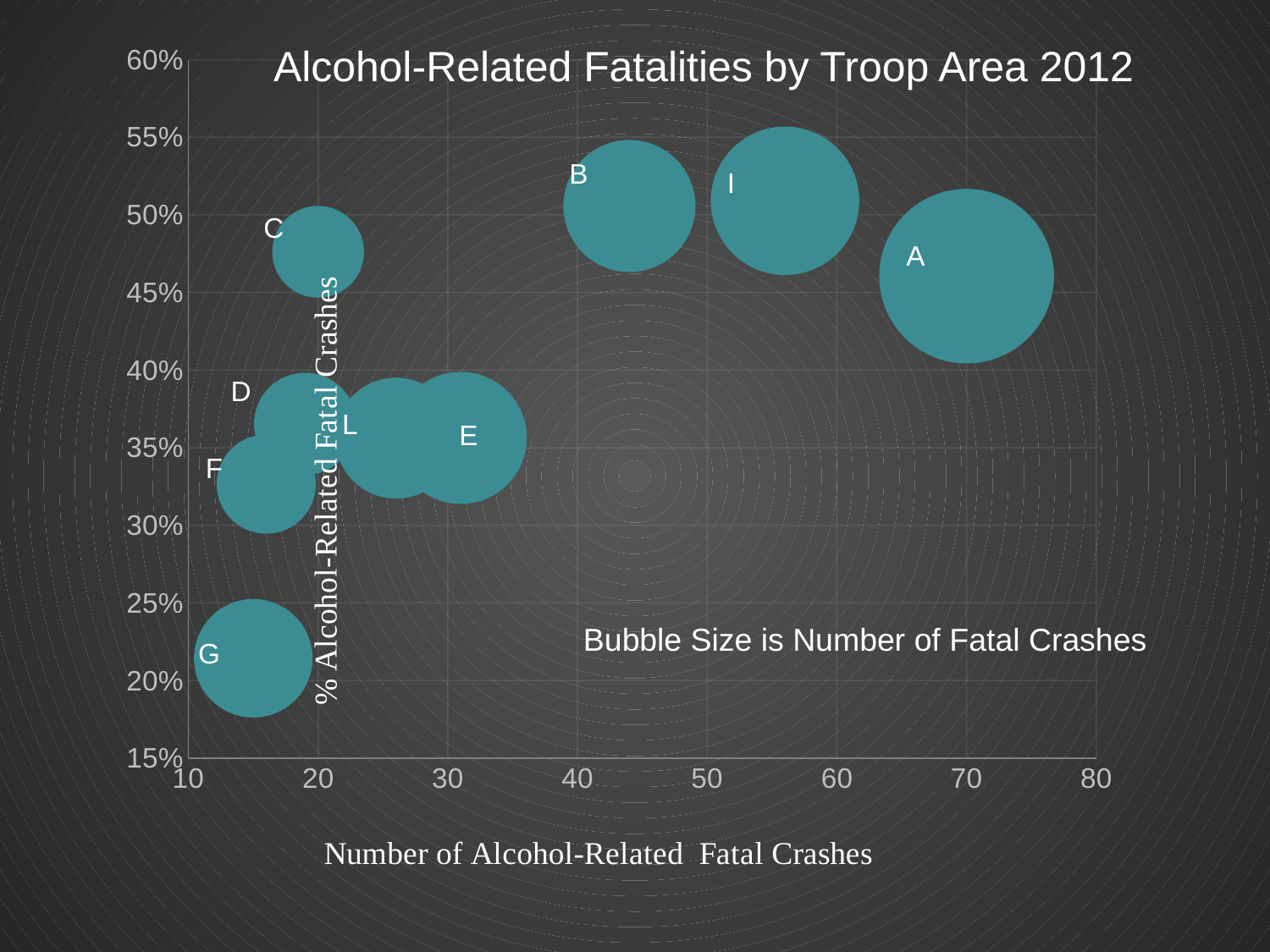
Which troop area has more alcohol-related fatal crashes on the x axis, I or E? I What is the title of the chart? Alcohol-Related Fatalities by Troop Area 2012 Which troop area has the highest number of alcohol-related fatal crashes (furthest right on the x axis)? A Which troop area has a higher percentage of alcohol-related fatal crashes, B or C? B Is the percentage of alcohol-related fatal crashes for troop area B greater or less than 45%? greater Which troop area has the largest bubble? A According to the note on the chart, what does the bubble size represent? Number of Fatal Crashes How many troop area bubbles are plotted on the chart? 9 What kind of chart is shown on the slide? Bubble chart Is the number of alcohol-related fatal crashes for troop area A greater or less than 60? greater Is the percentage of alcohol-related fatal crashes for troop area G greater or less than 25%? less Which troop area has the lowest percentage of alcohol-related fatal crashes? G